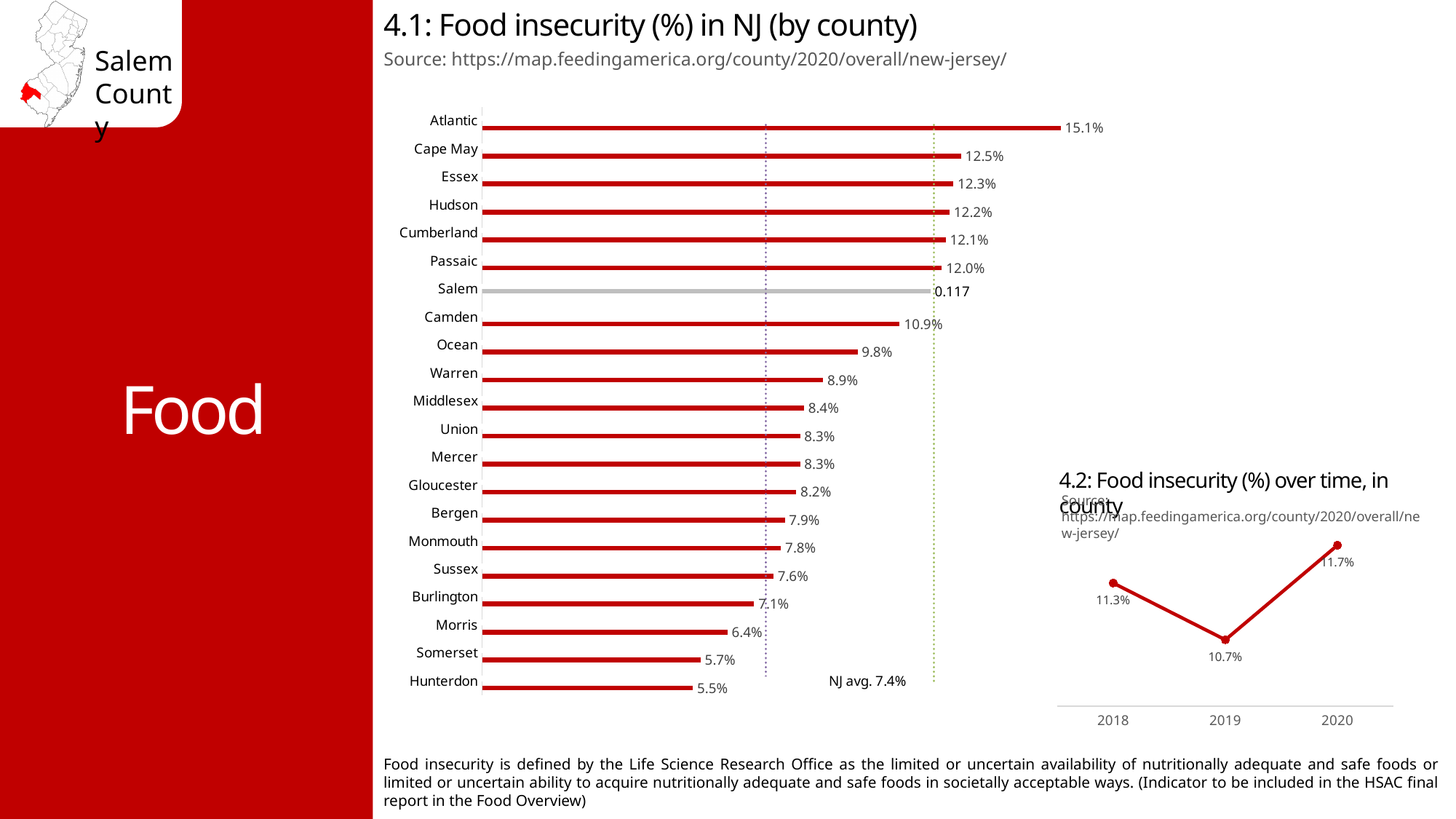
In chart 4.1 (Food insecurity (%) in NJ by county), which county has the lowest food insecurity? Hunterdon What kind of chart is chart 4.1 (Food insecurity (%) in NJ by county)? Bar chart In chart 4.1 (Food insecurity (%) in NJ by county), which county has the highest food insecurity? Atlantic In chart 4.2 (Food insecurity (%) over time, in county), what is the difference between the 2020 and 2018 values? 0.4 percentage points In chart 4.1 (Food insecurity (%) in NJ by county), what value is printed next to the Salem bar? 0.117 In chart 4.1 (Food insecurity (%) in NJ by county), what is the difference between Atlantic and Hunterdon? 9.6 percentage points In chart 4.2 (Food insecurity (%) over time, in county), what is the value for 2019? 10.7% In chart 4.1 (Food insecurity (%) in NJ by county), what NJ average value is labelled on the chart? NJ avg. 7.4% In chart 4.1 (Food insecurity (%) in NJ by county), how many counties are shown? 21 In chart 4.1 (Food insecurity (%) in NJ by county), which is higher, Camden or Ocean? Camden In chart 4.1 (Food insecurity (%) in NJ by county), what is the value for Atlantic? 15.1% In chart 4.2 (Food insecurity (%) over time, in county), which year has the highest value? 2020